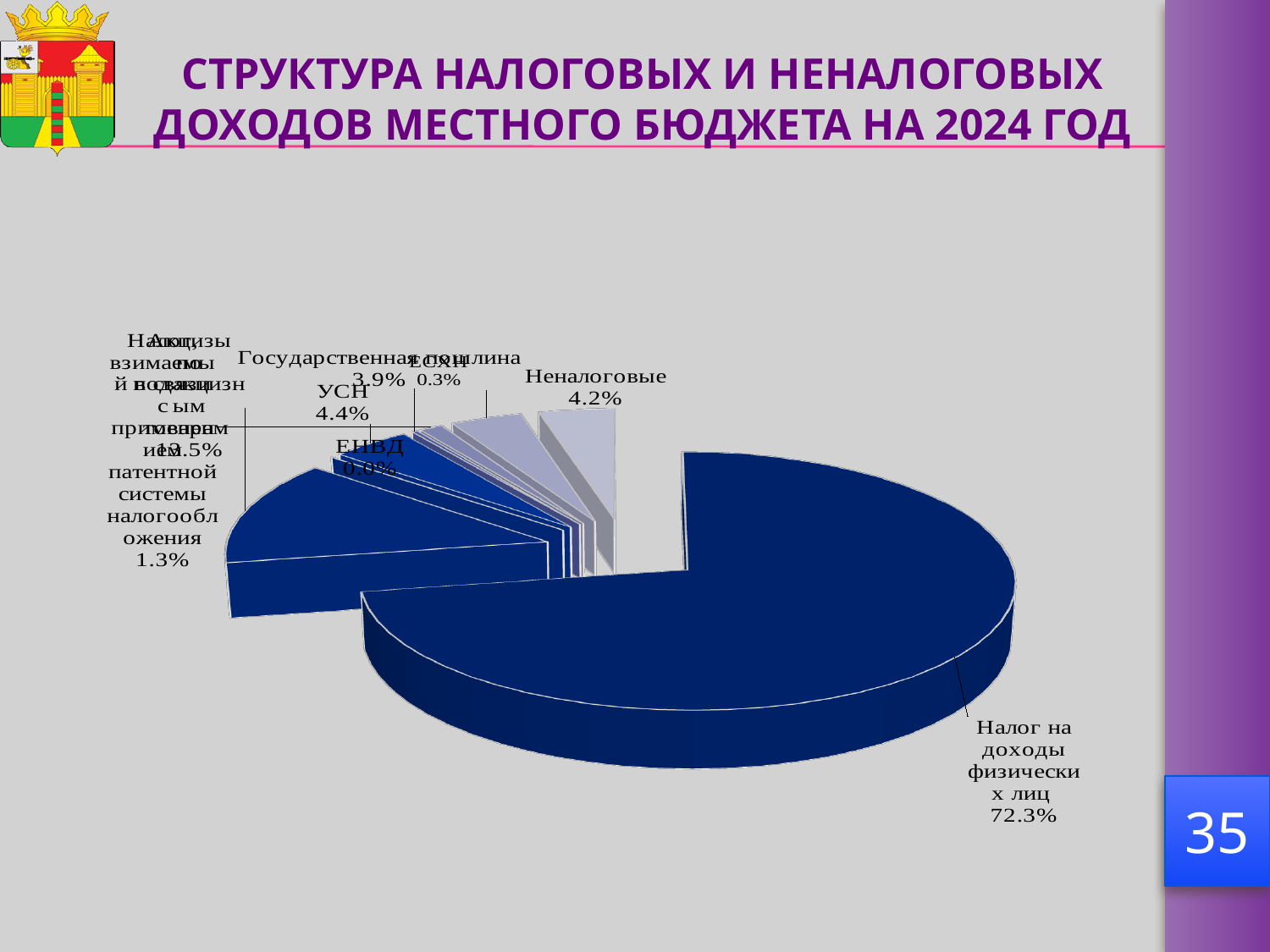
What percentage is shown for "УСН"? 4.4% What kind of chart is shown on the slide? pie chart Which category has the smallest share of the pie? ЕНВД Which category has the largest share of the pie? Налог на доходы физических лиц What percentage is shown for "ЕНВД"? 0.0% Which is larger, the share for "УСН" or the share for "Государственная пошлина"? УСН What is the difference between the share for "Неналоговые" and the share for "Государственная пошлина"? 0.3% What percentage is shown for "Неналоговые"? 4.2% What percentage is shown for the tax related to the patent system of taxation (патентной системы налогообложения)? 1.3% What share of the pie is labelled for "Налог на доходы физических лиц"? 72.3% What percentage is shown for "Государственная пошлина"? 3.9% What percentage is shown for "ЕСХН"? 0.3%